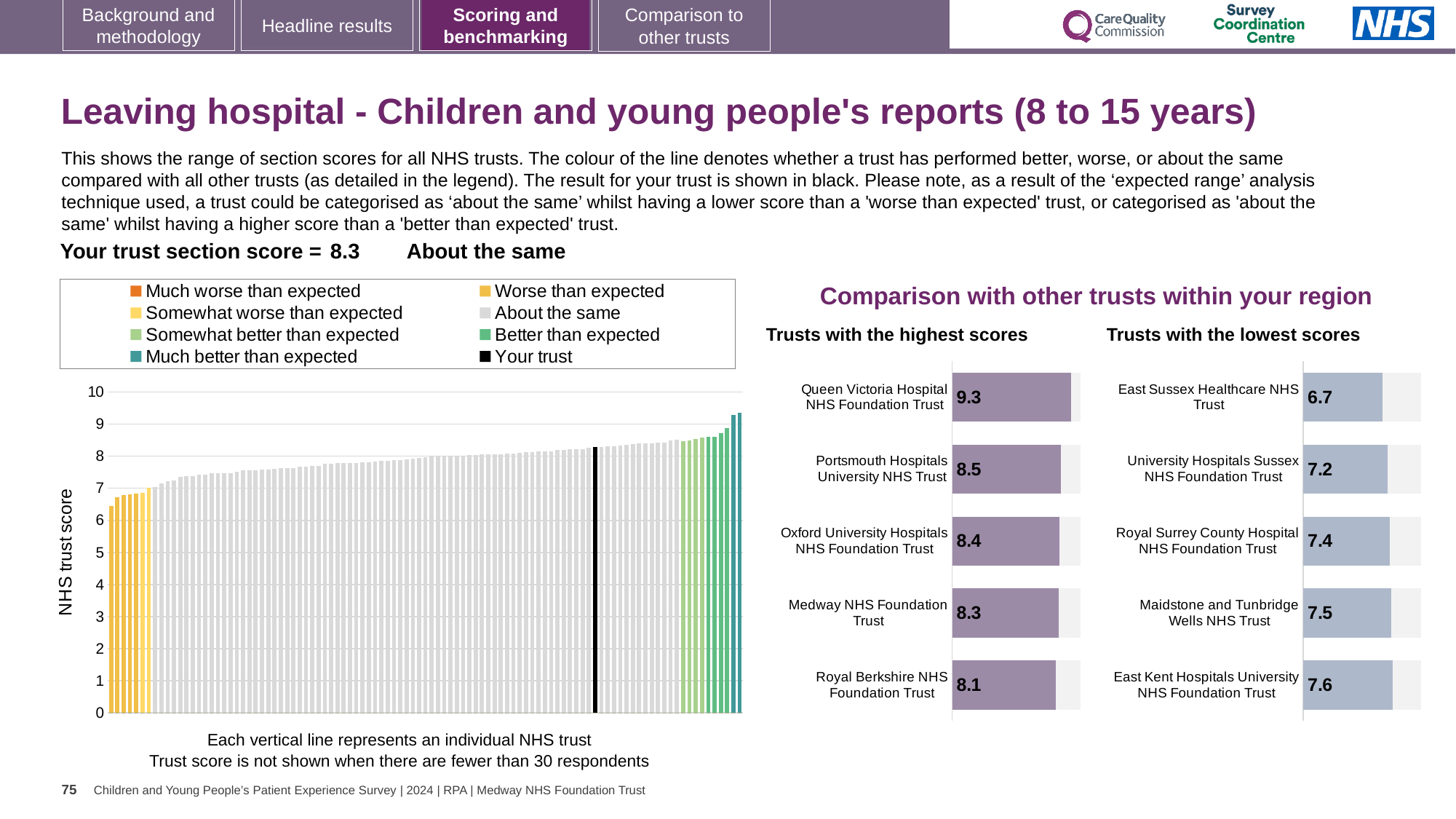
How many trusts are shown in the 'Trusts with the lowest scores' chart? 5 In the main NHS trust score chart, is the value of the leftmost (lowest) bar greater or less than 7? less How many entries does the legend of the main NHS trust score chart list? 8 In the 'Trusts with the highest scores' chart, what is the difference between the scores of Queen Victoria Hospital NHS Foundation Trust and Royal Berkshire NHS Foundation Trust? 1.2 What kind of chart is the main chart on the left showing NHS trust scores? Bar chart In the 'Trusts with the lowest scores' chart, which trust has the lowest score? East Sussex Healthcare NHS Trust In the 'Trusts with the highest scores' chart, which trust has the highest score? Queen Victoria Hospital NHS Foundation Trust In the main NHS trust score chart, do the bar values rise or fall from left to right? Rise In the 'Trusts with the lowest scores' chart, what is the score for Royal Surrey County Hospital NHS Foundation Trust? 7.4 In the 'Trusts with the highest scores' chart, which has the higher score: Portsmouth Hospitals University NHS Trust or Oxford University Hospitals NHS Foundation Trust? Portsmouth Hospitals University NHS Trust In the 'Trusts with the lowest scores' chart, how much higher is East Kent Hospitals University NHS Foundation Trust's score than East Sussex Healthcare NHS Trust's? 0.9 In the 'Trusts with the highest scores' chart, what is the score for Queen Victoria Hospital NHS Foundation Trust? 9.3